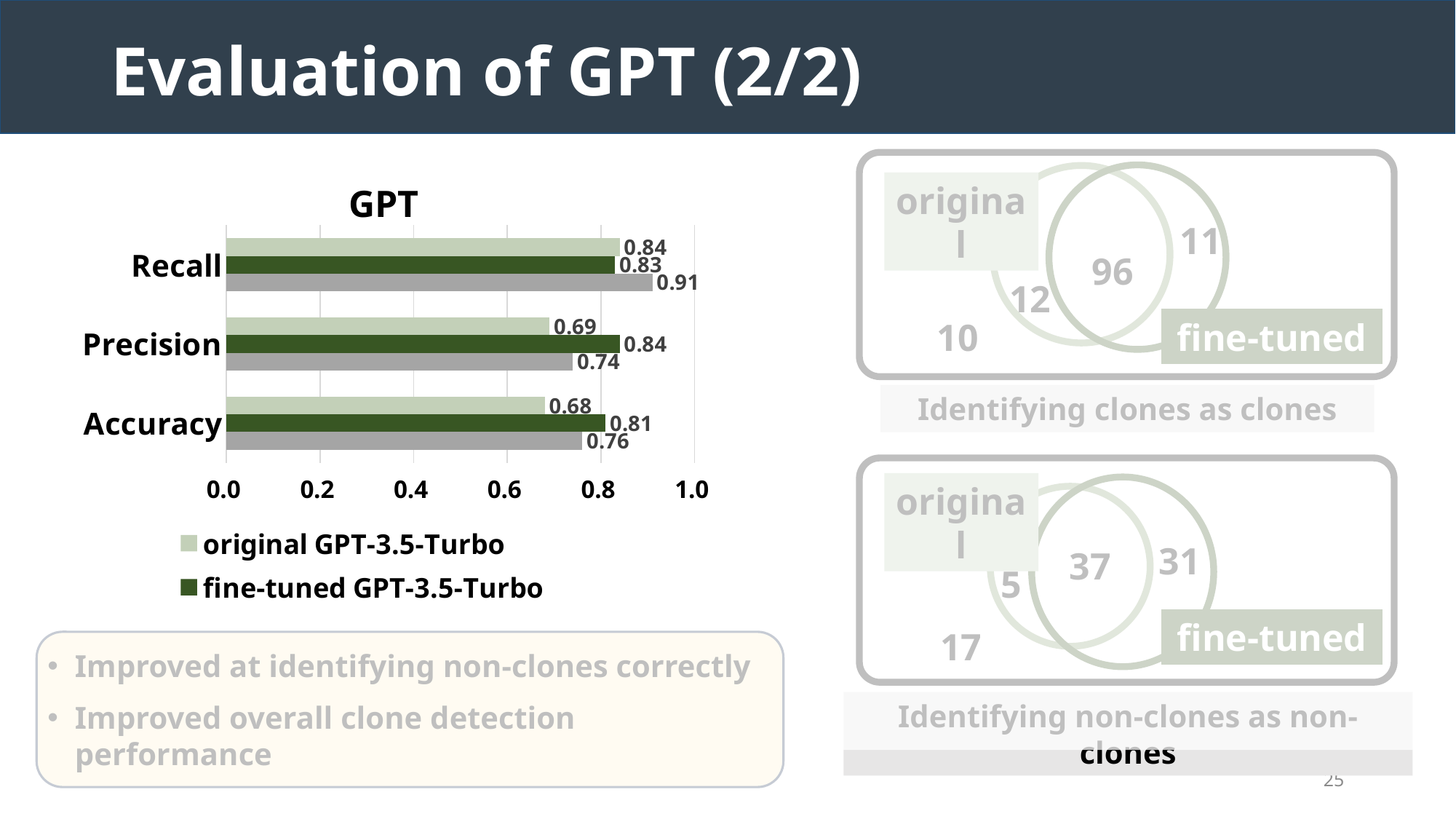
How much higher is the Precision of fine-tuned GPT-3.5-Turbo than that of original GPT-3.5-Turbo? 0.15 What is the Accuracy value for fine-tuned GPT-3.5-Turbo? 0.81 What is the difference in Accuracy between fine-tuned GPT-3.5-Turbo and original GPT-3.5-Turbo? 0.13 Which metric has the lowest value for fine-tuned GPT-3.5-Turbo? Accuracy What kind of chart is shown on the slide? bar chart Which metric has the highest value for original GPT-3.5-Turbo? Recall What is the Precision value for fine-tuned GPT-3.5-Turbo? 0.84 What is the title of the chart? GPT What is the Recall value for original GPT-3.5-Turbo? 0.84 What is the Accuracy value for original GPT-3.5-Turbo? 0.68 For Recall, which is larger: original GPT-3.5-Turbo or fine-tuned GPT-3.5-Turbo? original GPT-3.5-Turbo How many metric categories are shown on the chart's vertical axis? 3